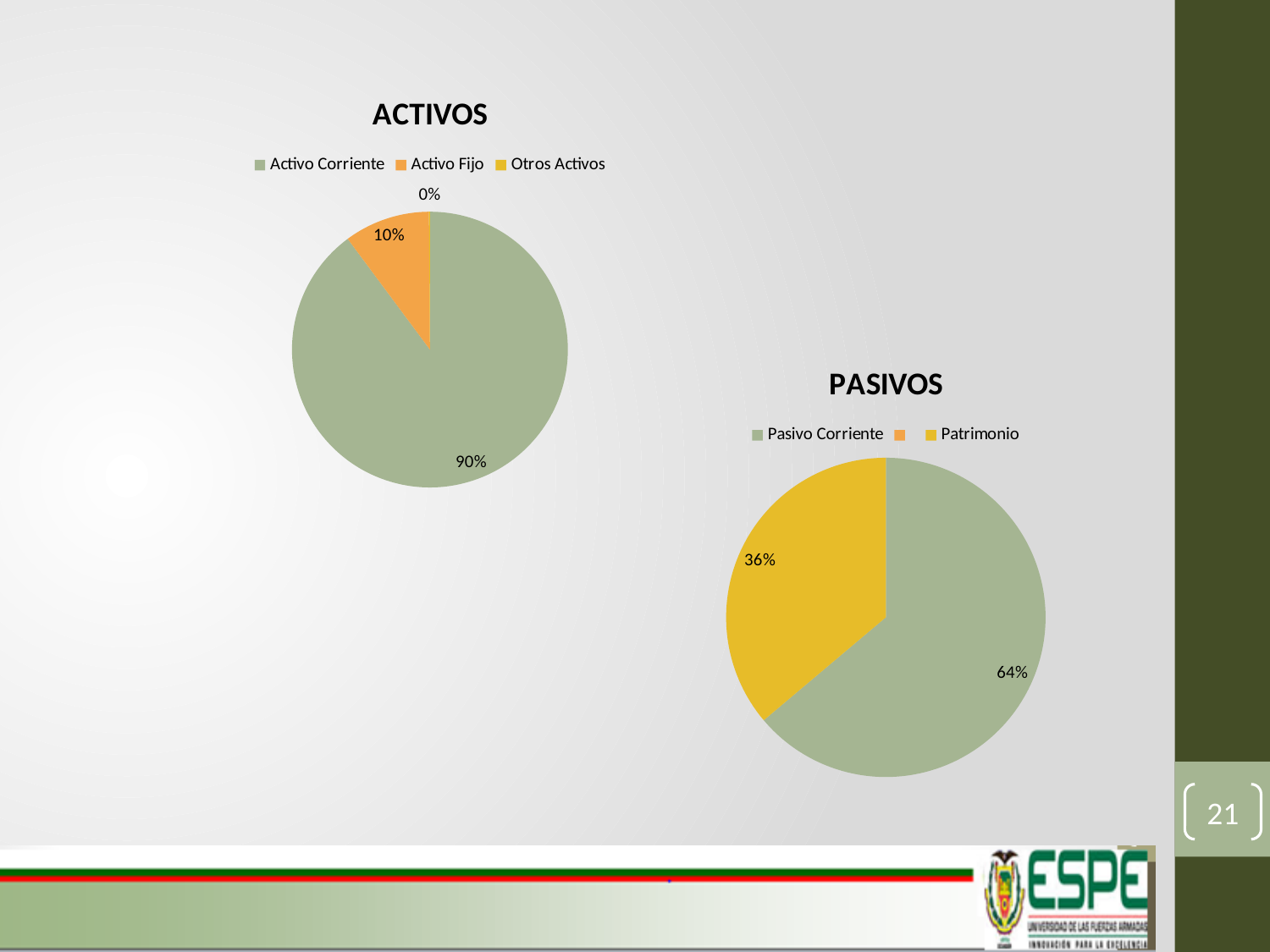
In the ACTIVOS chart, what share does Otros Activos have? 0% What kind of chart is the ACTIVOS chart? Pie chart In the ACTIVOS chart, what share does Activo Corriente have? 90% In the PASIVOS chart, which is larger, Pasivo Corriente or Patrimonio? Pasivo Corriente In the PASIVOS chart, what share does Pasivo Corriente have? 64% In the ACTIVOS chart, which category has the smallest slice? Otros Activos In the PASIVOS chart, what is the difference between the Pasivo Corriente and Patrimonio shares? 28% In the PASIVOS chart, what share does Patrimonio have? 36% In the ACTIVOS chart, what share does Activo Fijo have? 10% How many categories does the legend of the ACTIVOS chart list? 3 In the ACTIVOS chart, which category has the largest slice? Activo Corriente In the ACTIVOS chart, what is the difference between the Activo Corriente and Activo Fijo shares? 80%